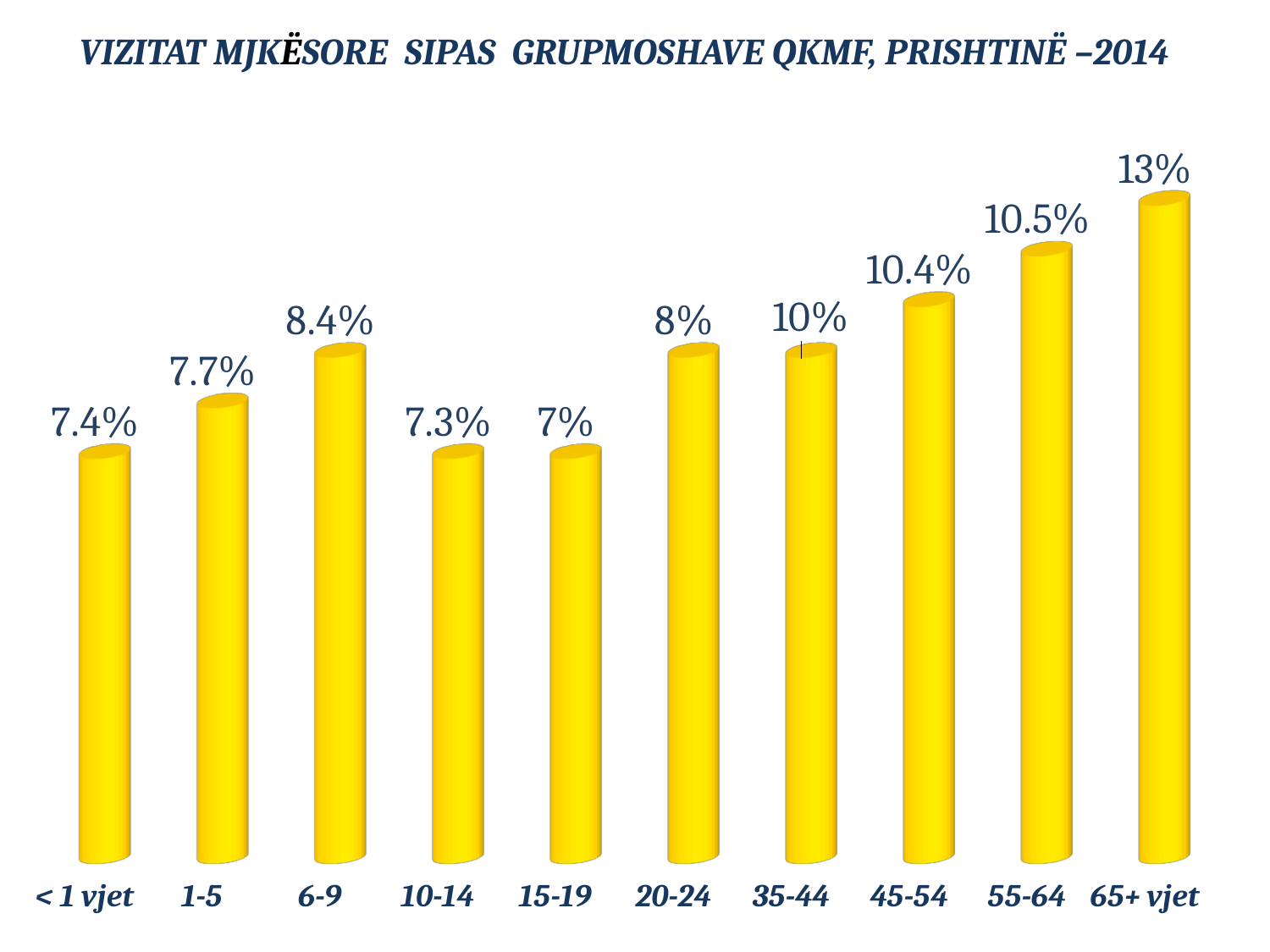
What is the value for the < 1 vjet age group? 7.4% What is the value for the 45-54 age group? 10.4% Which age group has the lowest value? 15-19 Which age group has the highest value? 65+ vjet What is the difference between the values for 65+ vjet and 15-19? 6% What is the title of the chart? VIZITAT MJKËSORE SIPAS GRUPMOSHAVE QKMF, PRISHTINË –2014 What is the value for the 10-14 age group? 7.3% How many age groups are shown in the chart? 10 What is the value for the 65+ vjet age group? 13% What kind of chart is shown on the slide? bar chart Which is larger, the value for 20-24 or the value for 35-44? 35-44 What is the difference between the values for 6-9 and 1-5? 0.7%